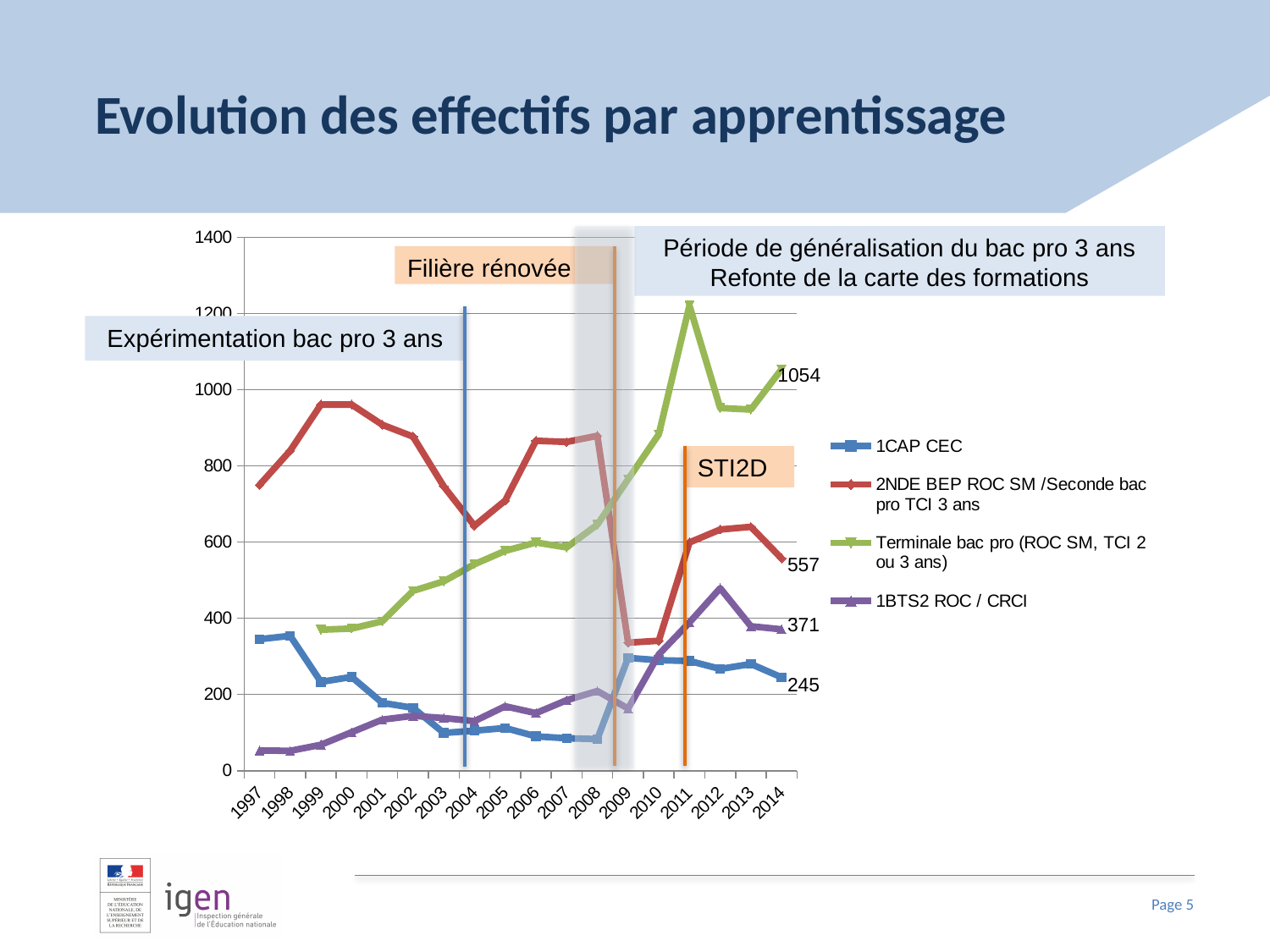
What kind of chart is shown on the slide? line chart Which series has the lowest value in 2014? 1CAP CEC What is the value for 1CAP CEC in 2014? 245 What is the difference between the 2014 values for Terminale bac pro (ROC SM, TCI 2 ou 3 ans) and 2NDE BEP ROC SM /Seconde bac pro TCI 3 ans? 497 Is the value for 2NDE BEP ROC SM /Seconde bac pro TCI 3 ans in 2000 greater or less than 800? greater Which series has the highest value in 2014? Terminale bac pro (ROC SM, TCI 2 ou 3 ans) Is the value for 1BTS2 ROC / CRCI in 1997 greater or less than 200? less What is the value for 2NDE BEP ROC SM /Seconde bac pro TCI 3 ans in 2014? 557 How many series does the legend list? 4 What is the value for 1BTS2 ROC / CRCI in 2014? 371 Does the value for 1CAP CEC rise or fall from 1998 to 2003? fall What is the value for Terminale bac pro (ROC SM, TCI 2 ou 3 ans) in 2014? 1054